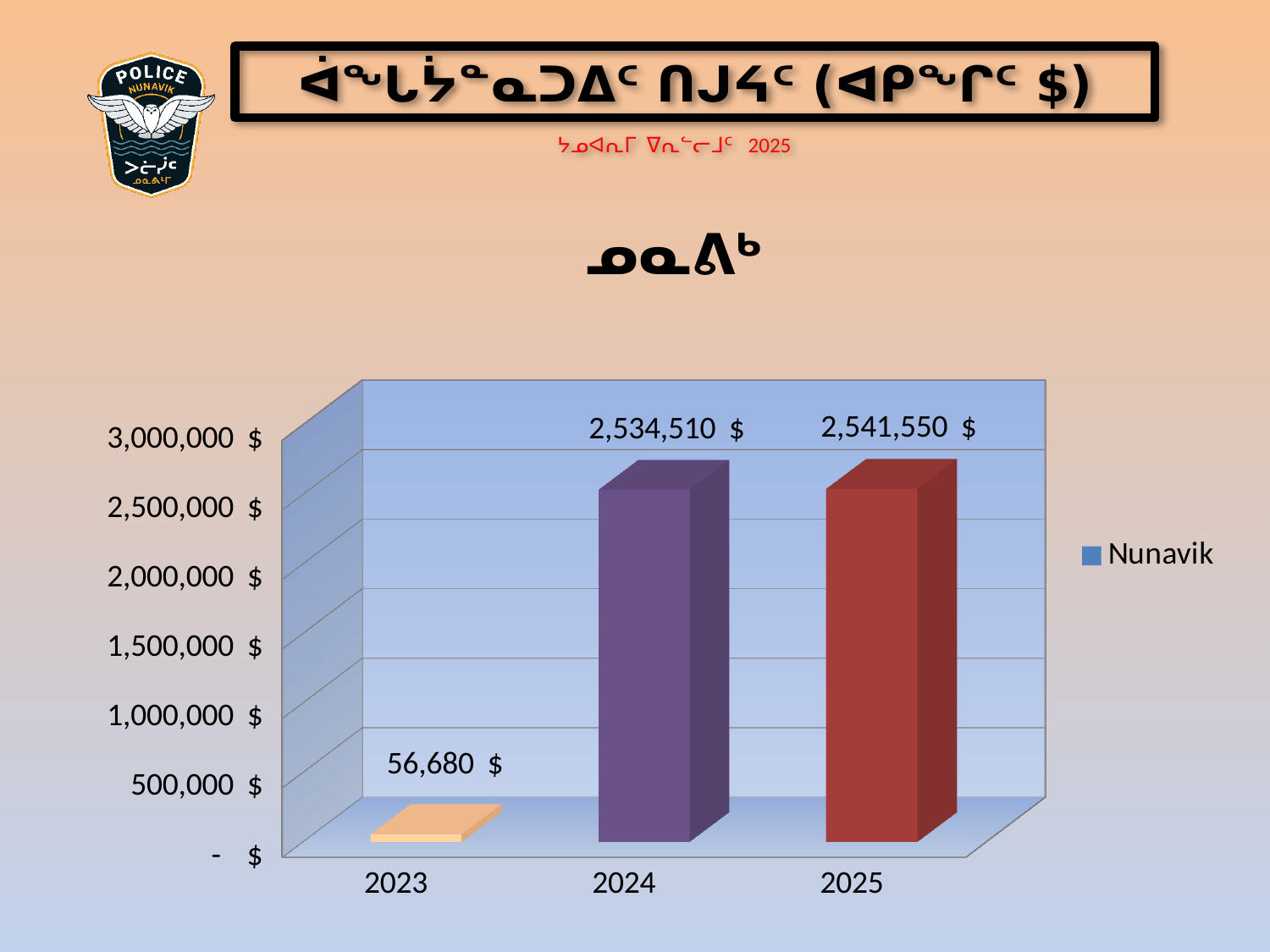
What is the value for 2023? 56,680 $ Which is larger, the value for 2024 or the value for 2025? 2025 What entry does the legend list? Nunavik What is the value for 2024? 2,534,510 $ How many years are shown on the x axis? 3 What is the difference between the values for 2024 and 2023? 2,477,830 $ Which year has the highest value according to the data labels? 2025 What kind of chart is shown on the slide? bar chart Which year has the lowest value? 2023 Is the value for 2023 greater or less than 500,000 $? less What is the difference between the values for 2025 and 2024? 7,040 $ What is the value for 2025? 2,541,550 $